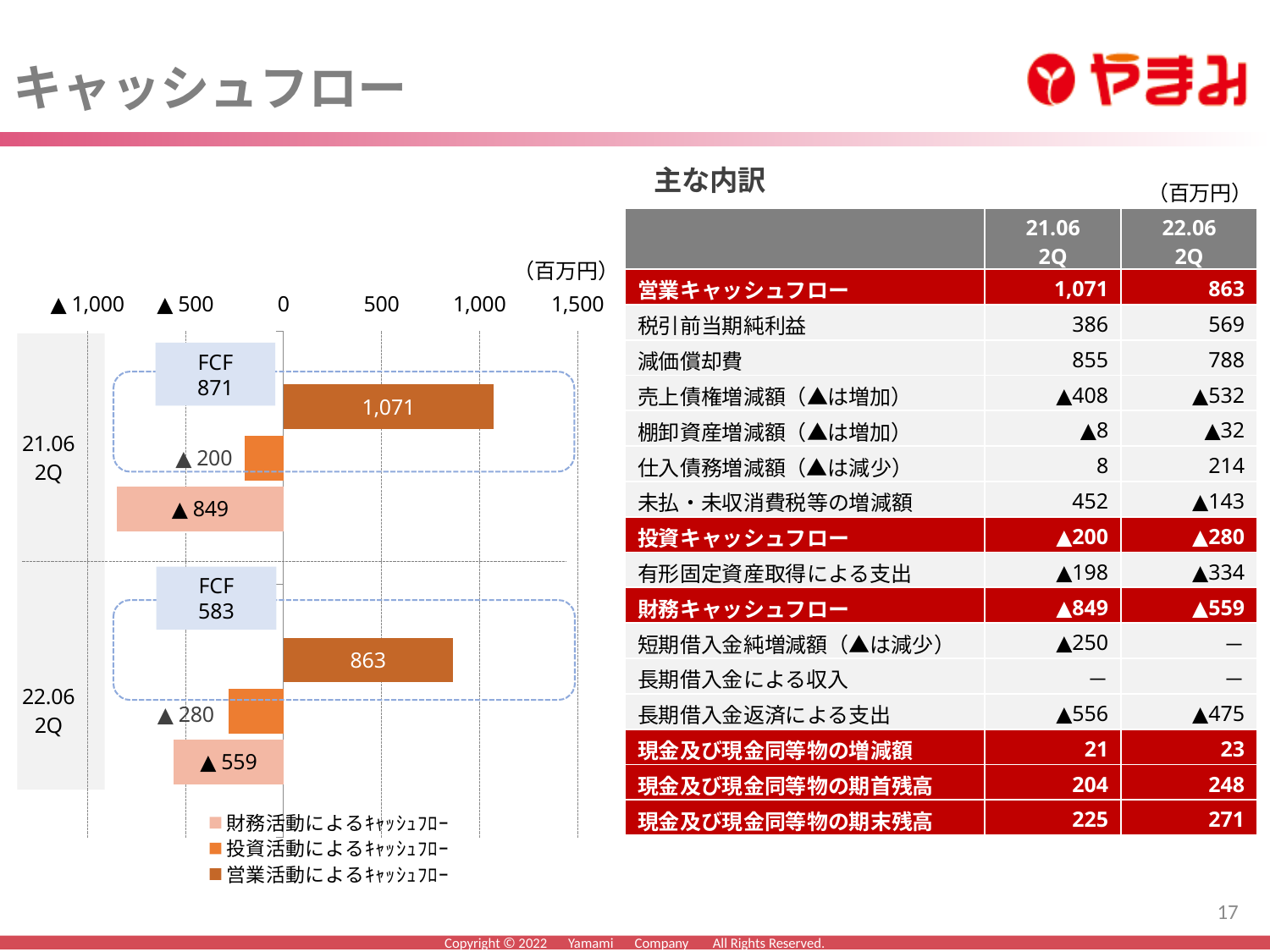
What unit is indicated above the chart's axis? 百万円 What is the difference between the FCF values for 21.06 2Q and 22.06 2Q shown in the chart? 288 How many series does the chart legend list? 3 What is the value of 投資活動によるキャッシュフロー for 21.06 2Q in the chart? ▲200 By how much did 営業活動によるキャッシュフロー decrease from 21.06 2Q to 22.06 2Q in the chart? 208 Which period has the larger 営業活動によるキャッシュフロー bar, 21.06 2Q or 22.06 2Q? 21.06 2Q What FCF value is shown for 22.06 2Q in the chart? 583 What is the value of 営業活動によるキャッシュフロー for 22.06 2Q in the chart? 863 How many periods (categories) are plotted on the chart? 2 What is the value of 営業活動によるキャッシュフロー for 21.06 2Q in the chart? 1,071 What is the value of 財務活動によるキャッシュフロー for 22.06 2Q in the chart? ▲559 What type of chart is shown on the left of the slide? bar chart